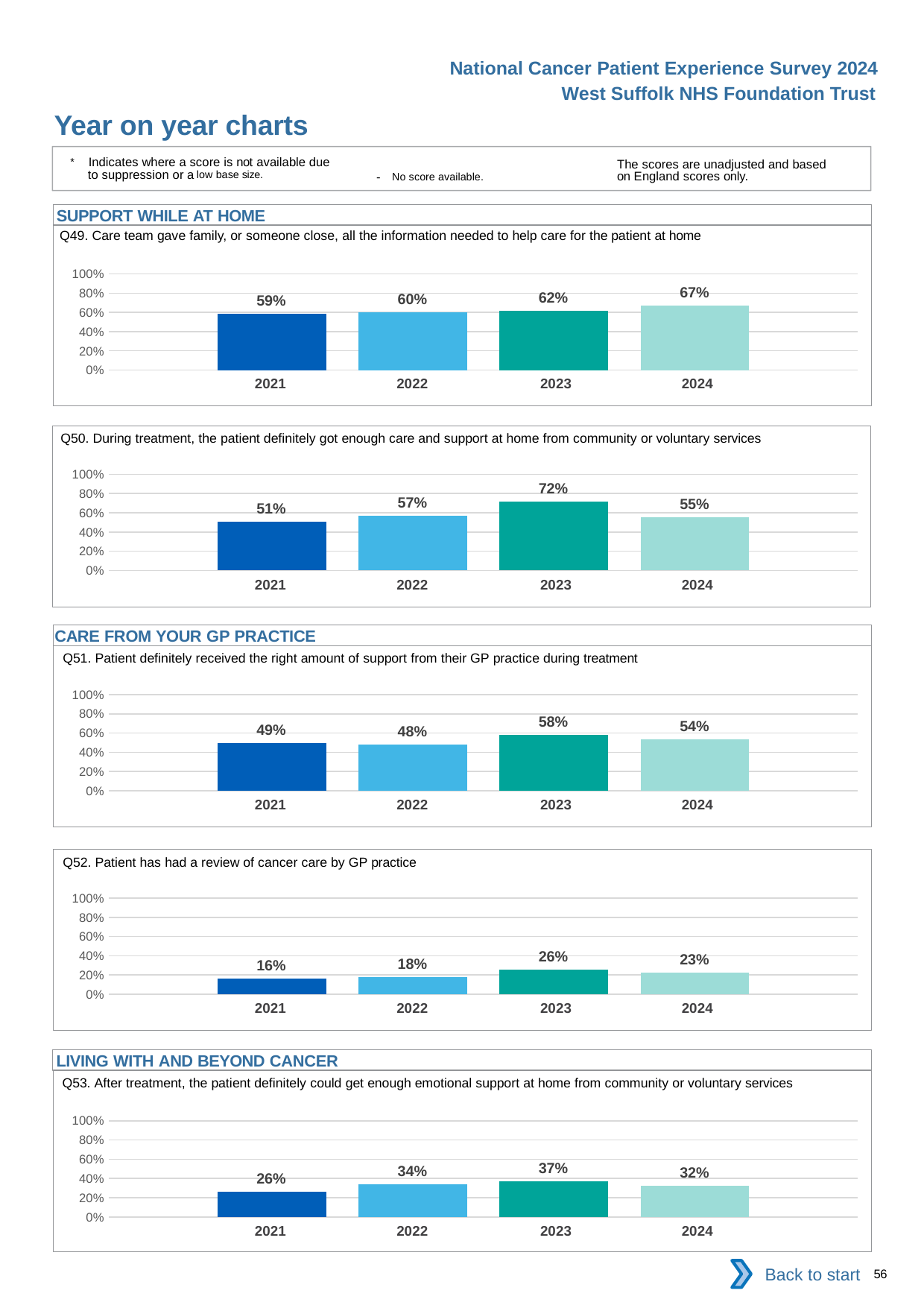
In the Q49 chart, do the values rise or fall from 2021 to 2024? rise In the Q49 chart, what is the value for 2024? 67% In the Q50 chart, which year has the highest value? 2023 In the Q52 chart, what is the value for 2022? 18% In the Q51 chart, what is the value for 2023? 58% What type of chart is the Q50 chart? bar chart In the Q52 chart, is the value for 2021 larger or smaller than the value for 2024? smaller How many years are shown in the Q53 chart? 4 In the Q53 chart, what is the difference between the 2023 and 2021 values? 11% In the Q53 chart, is the value for 2024 greater or less than 40%? less In the Q50 chart, what is the difference between the 2023 and 2024 values? 17% In the Q51 chart, which year has the lowest value? 2022